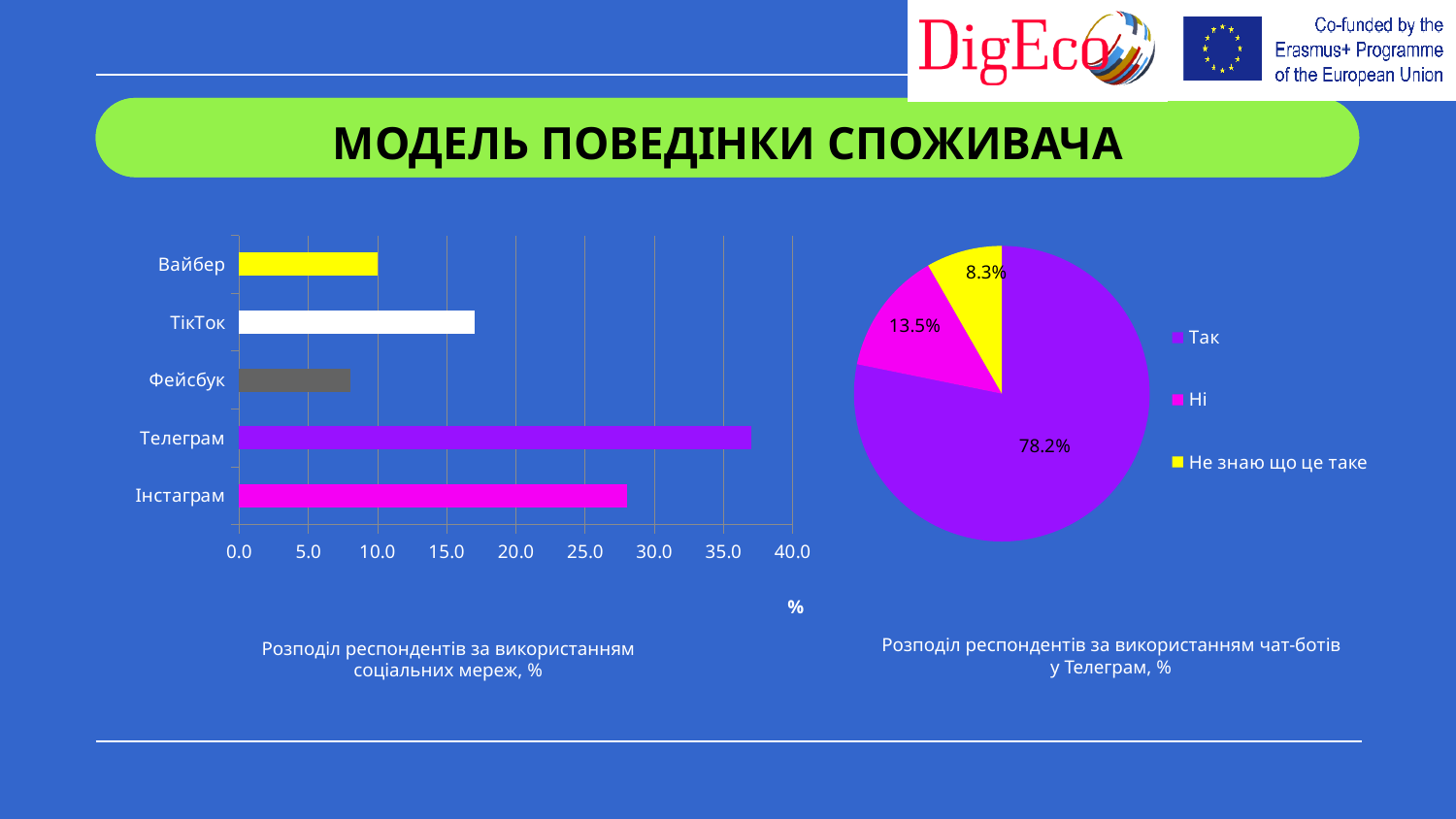
On the left bar chart, which is larger, the value for ТікТок or the value for Фейсбук? ТікТок What kind of chart is the left chart on the slide? bar chart On the left bar chart, which social network has the highest share of respondents? Телеграм On the left bar chart, is the value for ТікТок greater or less than 20.0? less On the left bar chart, is the value for Інстаграм greater or less than 25.0? greater On the left bar chart, is the value for Телеграм greater or less than 35.0? greater How many social networks are shown on the left bar chart? 5 On the right pie chart, what share of respondents answered Так? 78.2% On the right pie chart, what is the difference between the Так and Ні shares? 64.7% On the right pie chart, what share of respondents answered Ні? 13.5% On the left bar chart, which social network has the lowest share of respondents? Фейсбук How many entries does the legend of the right pie chart list? 3